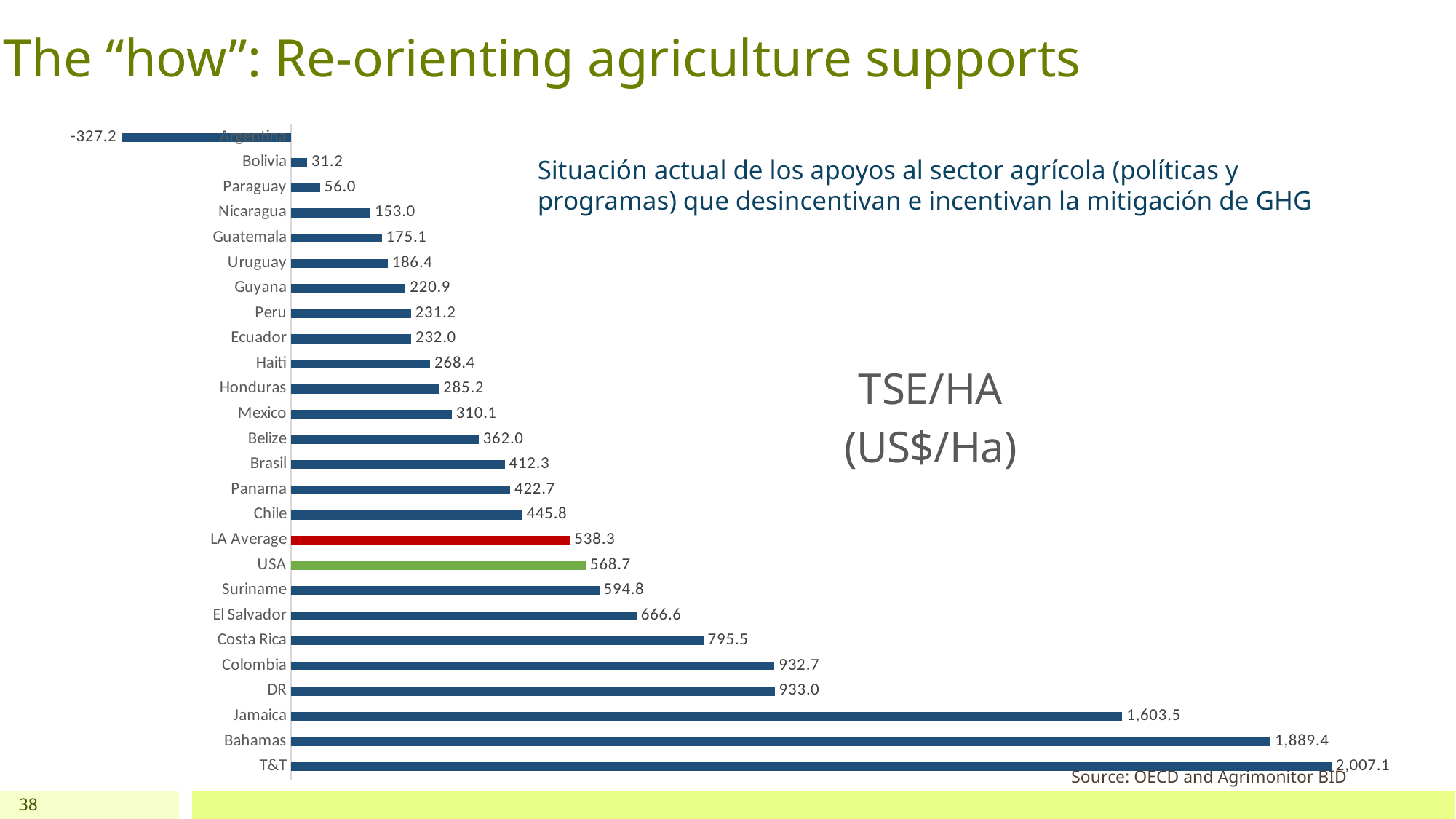
What is the value shown for LA Average? 538.3 Which country has the highest TSE/HA value? T&T What is the difference between the USA value and the LA Average value? 30.4 Which has a larger value, Chile or Brasil? Chile What is the difference between the values for T&T and Bahamas? 117.7 How many categories (bars) are shown on the chart? 26 Which category has the lowest value on the chart? Argentina What is the value shown for Argentina? -327.2 Which has a larger value, Costa Rica or El Salvador? Costa Rica What type of chart is shown on the slide? Bar chart What is the TSE/HA value for Jamaica? 1,603.5 What colour is the bar for LA Average? Red